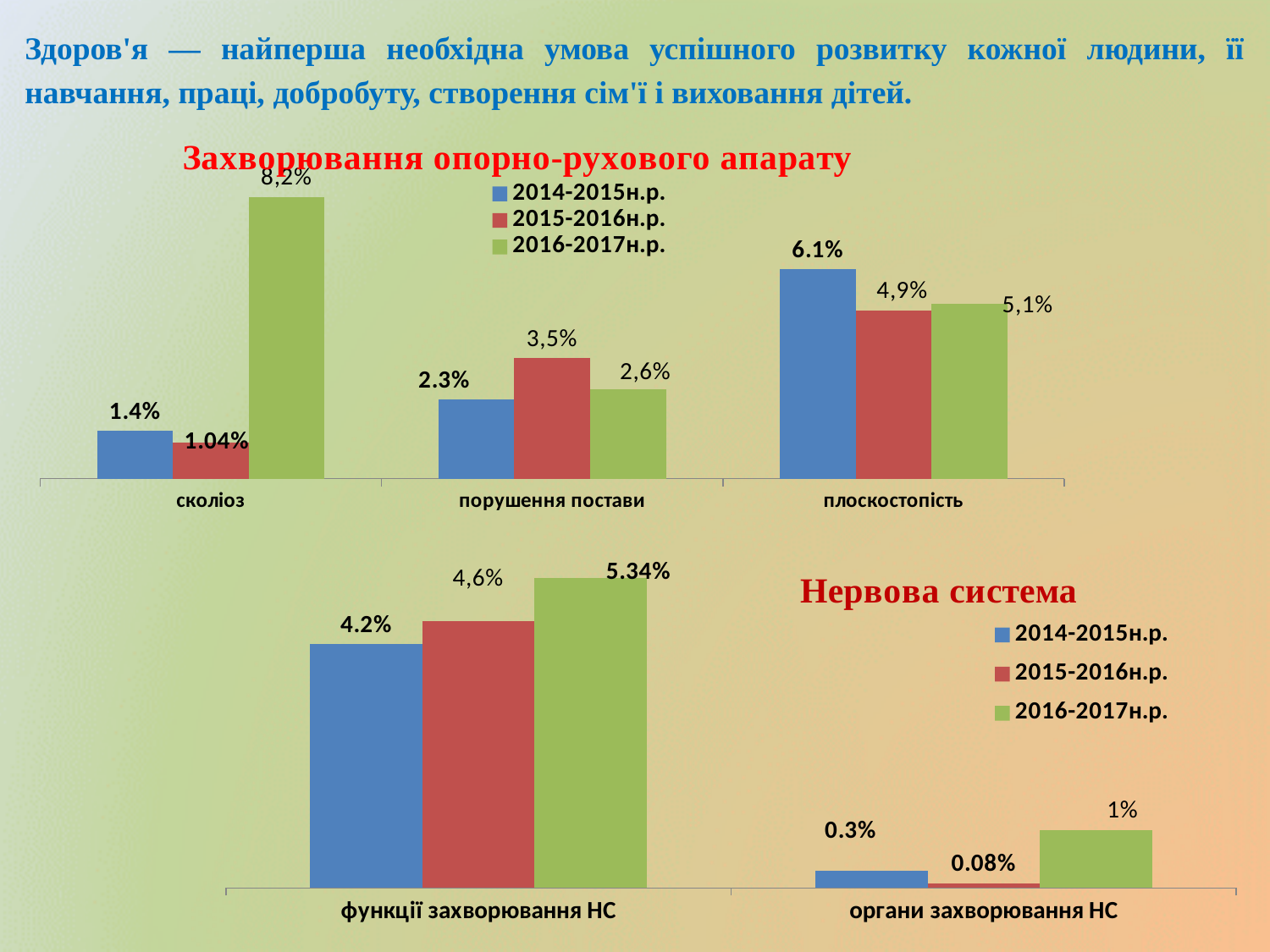
In the chart 'Нервова система', which is larger for функції захворювання НС: the 2014-2015н.р. value or the 2015-2016н.р. value? 2015-2016н.р. In the chart 'Захворювання опорно-рухового апарату', how many categories are shown on the x axis? 3 What type of chart is 'Нервова система'? bar chart In the chart 'Нервова система', how many series does the legend list? 3 In the chart 'Захворювання опорно-рухового апарату', what is the value for сколіоз in 2016-2017н.р.? 8,2% In the chart 'Нервова система', what is the value for функції захворювання НС in 2016-2017н.р.? 5.34% In the chart 'Нервова система', what is the value for органи захворювання НС in 2015-2016н.р.? 0.08% In the chart 'Захворювання опорно-рухового апарату', which category has the lowest value in 2015-2016н.р.? сколіоз In the chart 'Захворювання опорно-рухового апарату', what is the value for порушення постави in 2015-2016н.р.? 3,5% In the chart 'Захворювання опорно-рухового апарату', what is the value for плоскостопість in 2014-2015н.р.? 6.1% In the chart 'Захворювання опорно-рухового апарату', what is the difference between the 2014-2015н.р. and 2015-2016н.р. values for плоскостопість? 1.2% In the chart 'Захворювання опорно-рухового апарату', which category has the highest value in 2016-2017н.р.? сколіоз